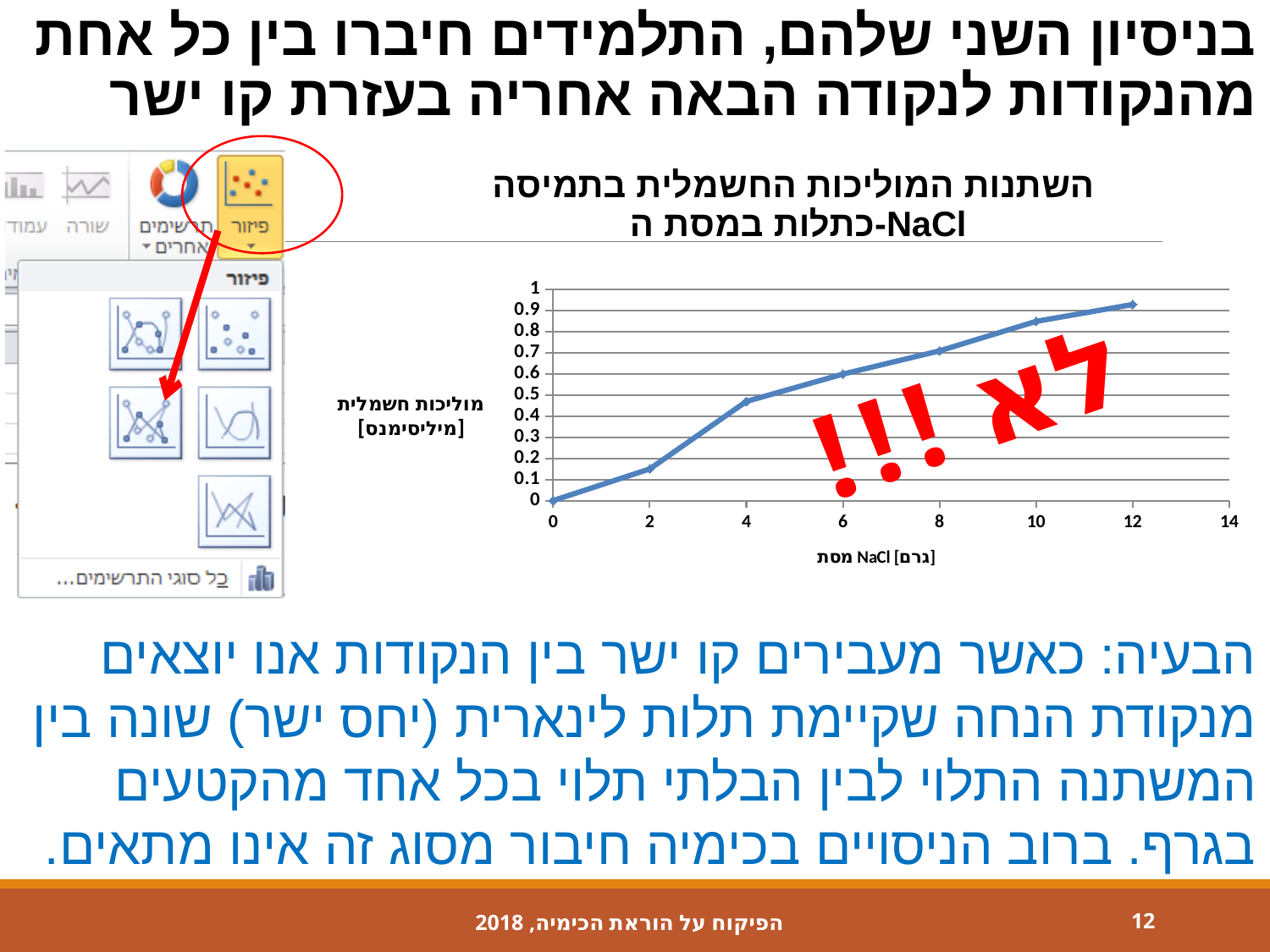
What is the label of the x axis of the chart? מסת NaCl [גרם] How many data points are plotted on the chart? 7 At which NaCl mass is the electrical conductivity lowest? 0 Which is larger: the conductivity at NaCl mass 8 or at NaCl mass 4? NaCl mass 8 Is the conductivity value at NaCl mass 10 greater or less than 0.8? greater At which NaCl mass is the electrical conductivity highest? 12 Do the values rise or fall as the NaCl mass increases along the x axis? Rise Is the conductivity value at NaCl mass 2 greater or less than 0.2? less What is the title of the chart? השתנות המוליכות החשמלית בתמיסה כתלות במסת ה-NaCl Is the conductivity value at NaCl mass 4 greater or less than 0.4? greater What kind of chart is shown on the slide? Scatter chart with straight lines connecting the points